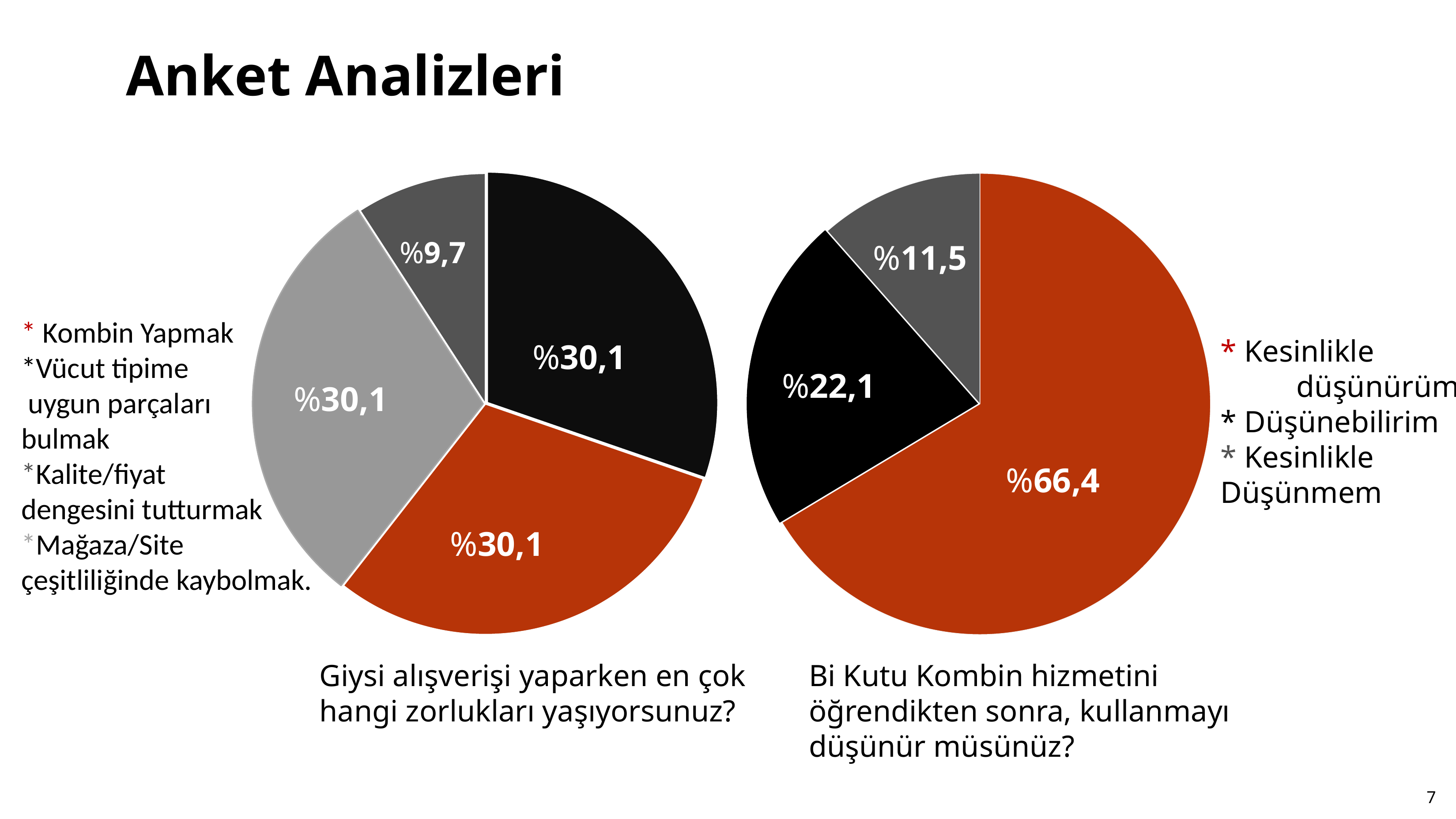
How many slices does the left pie chart (Giysi alışverişi yaparken en çok hangi zorlukları yaşıyorsunuz?) have? 4 In the right pie chart, what is the value for Düşünebilirim? %22,1 In the right pie chart, what is the difference between the shares for Kesinlikle düşünürüm and Düşünebilirim? %44,3 In the right pie chart, which response has the smallest share? Kesinlikle Düşünmem In the right pie chart, which response has the largest share? Kesinlikle düşünürüm In the right pie chart, which is larger: Düşünebilirim or Kesinlikle Düşünmem? Düşünebilirim In the left pie chart, how many slices are labelled %30,1? 3 How many slices does the right pie chart have? 3 In the right pie chart (Bi Kutu Kombin hizmetini öğrendikten sonra, kullanmayı düşünür müsünüz?), what is the value for Kesinlikle düşünürüm? %66,4 What type of chart is the left chart on the slide? Pie chart In the right pie chart, what is the value for Kesinlikle Düşünmem? %11,5 In the left pie chart, what is the value of the smallest slice? %9,7